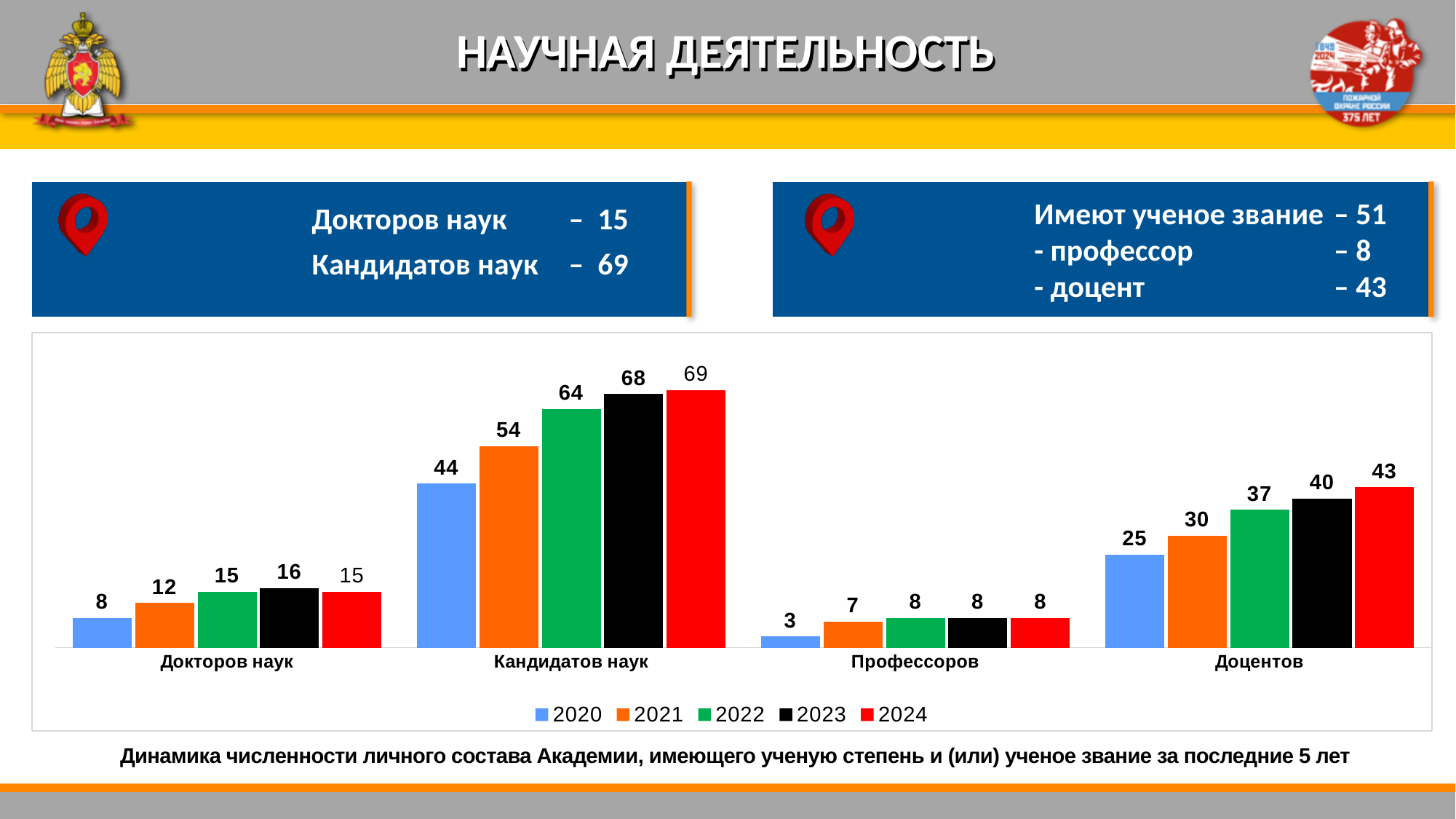
Which category has the highest value in 2024? Кандидатов наук How many series does the legend list? 5 What is the difference between the 2024 and 2020 values for Доцентов? 18 What is the value for Профессоров in 2021? 7 Which category has the lowest value in 2020? Профессоров Do the values for Кандидатов наук rise or fall from 2020 to 2024? Rise What is the value for Кандидатов наук in 2022? 64 What kind of chart is shown on the slide? Bar chart Which is larger: the 2023 value for Докторов наук or the 2024 value for Докторов наук? 2023 How many categories are shown on the x axis? 4 Which colour represents the 2023 series in the legend? Black What is the value for Доцентов in 2020? 25